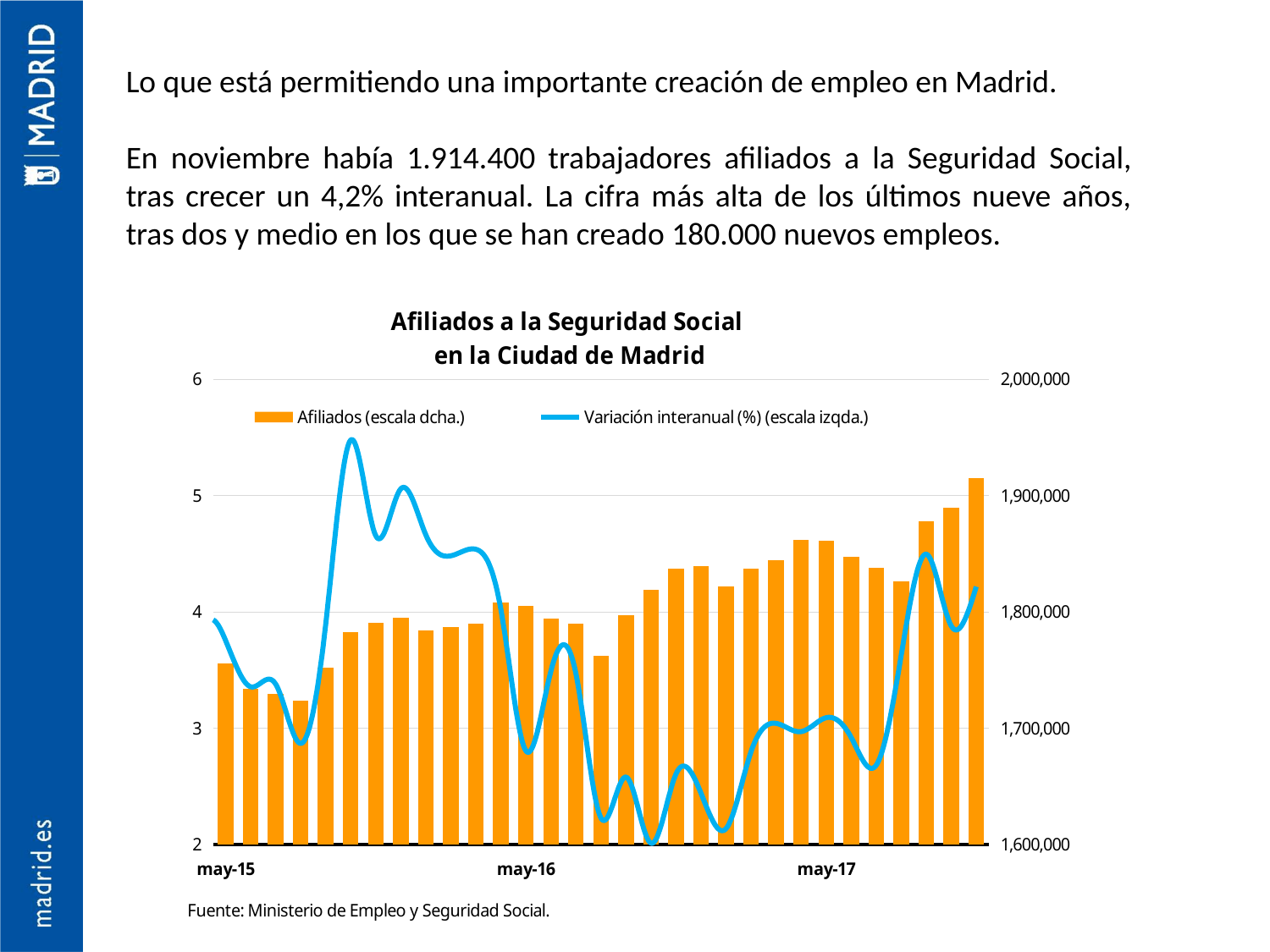
How many series does the chart legend list? 2 Is the lowest point of the 'Variación interanual (%)' line greater or less than 3 on the left axis? less Which bar is the tallest in the chart? The last (rightmost) bar Is the lowest bar located near the start or near the end of the series? Near the start Is the highest point of the 'Variación interanual (%)' line greater or less than 5 on the left axis? greater According to the legend, on which axis is the 'Afiliados' series plotted? The right axis (escala dcha.) Is the value of the rightmost (last) bar greater or less than 1,900,000? greater Which bar is taller, the one at may-16 or the one at may-17? may-17 Do the 'Afiliados' bars generally rise or fall from may-15 to the end of the series? rise What kind of chart is shown on the slide? A combined bar and line chart What is the title of the chart? Afiliados a la Seguridad Social en la Ciudad de Madrid